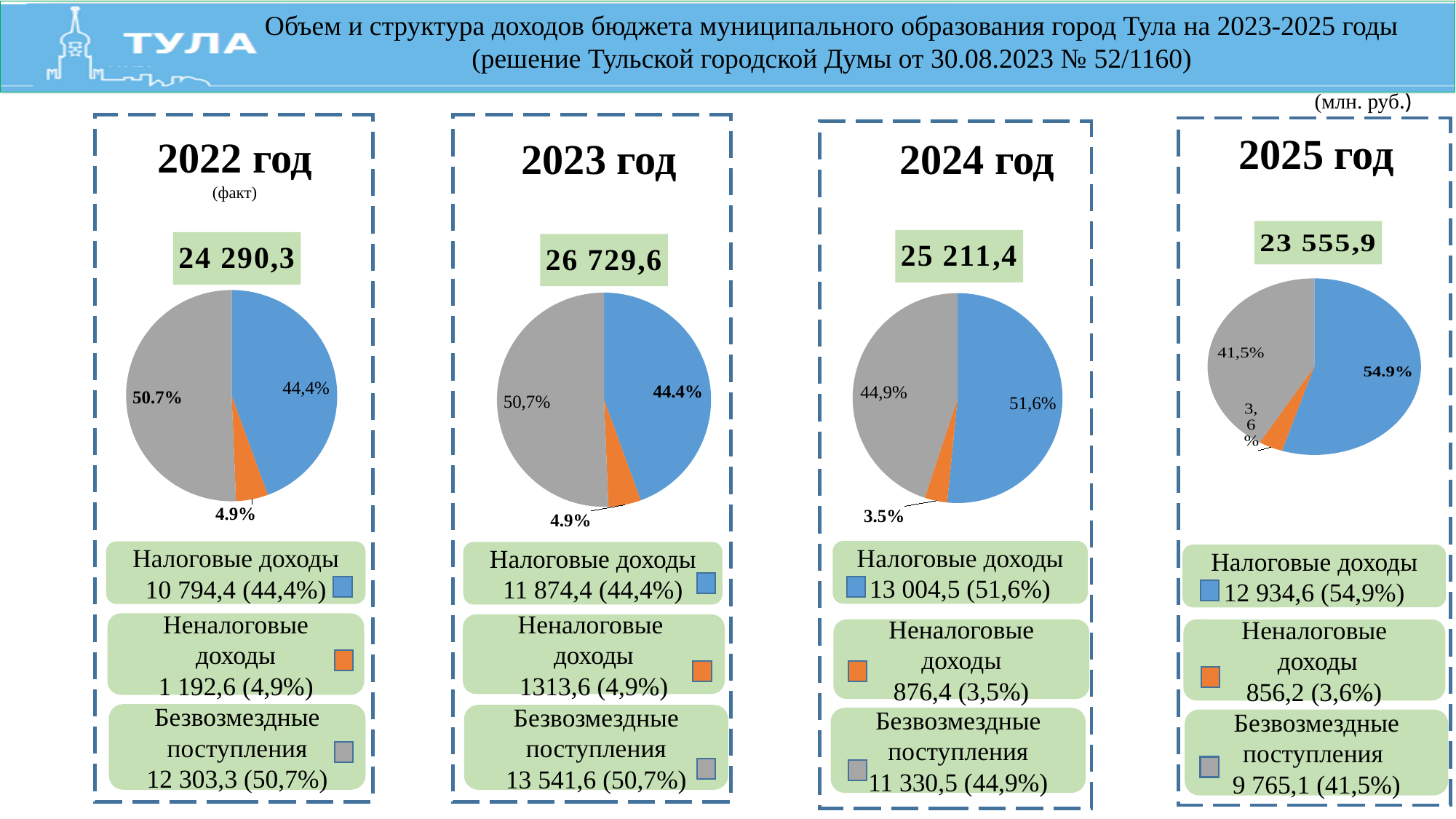
In the 2025 год pie chart, which category has the smallest slice? Неналоговые доходы In the 2022 год pie chart, which category has the largest slice? Безвозмездные поступления In the 2022 год pie chart, what share is shown for Безвозмездные поступления? 50,7% In the 2025 год chart, what is the value of Безвозмездные поступления in млн. руб.? 9 765,1 In the 2023 год pie chart, what share is shown for Налоговые доходы? 44,4% In the 2024 год pie chart, which is larger: Налоговые доходы or Безвозмездные поступления? Налоговые доходы In the 2025 год pie chart, what share is shown for Налоговые доходы? 54,9% How many slices does the 2023 год pie chart have? 3 In the 2024 год chart, what is the value of Налоговые доходы in млн. руб.? 13 004,5 In the 2023 год chart, what is the difference between Безвозмездные поступления and Налоговые доходы in млн. руб.? 1 667,2 What type of chart is used for the 2022 год data? Pie chart